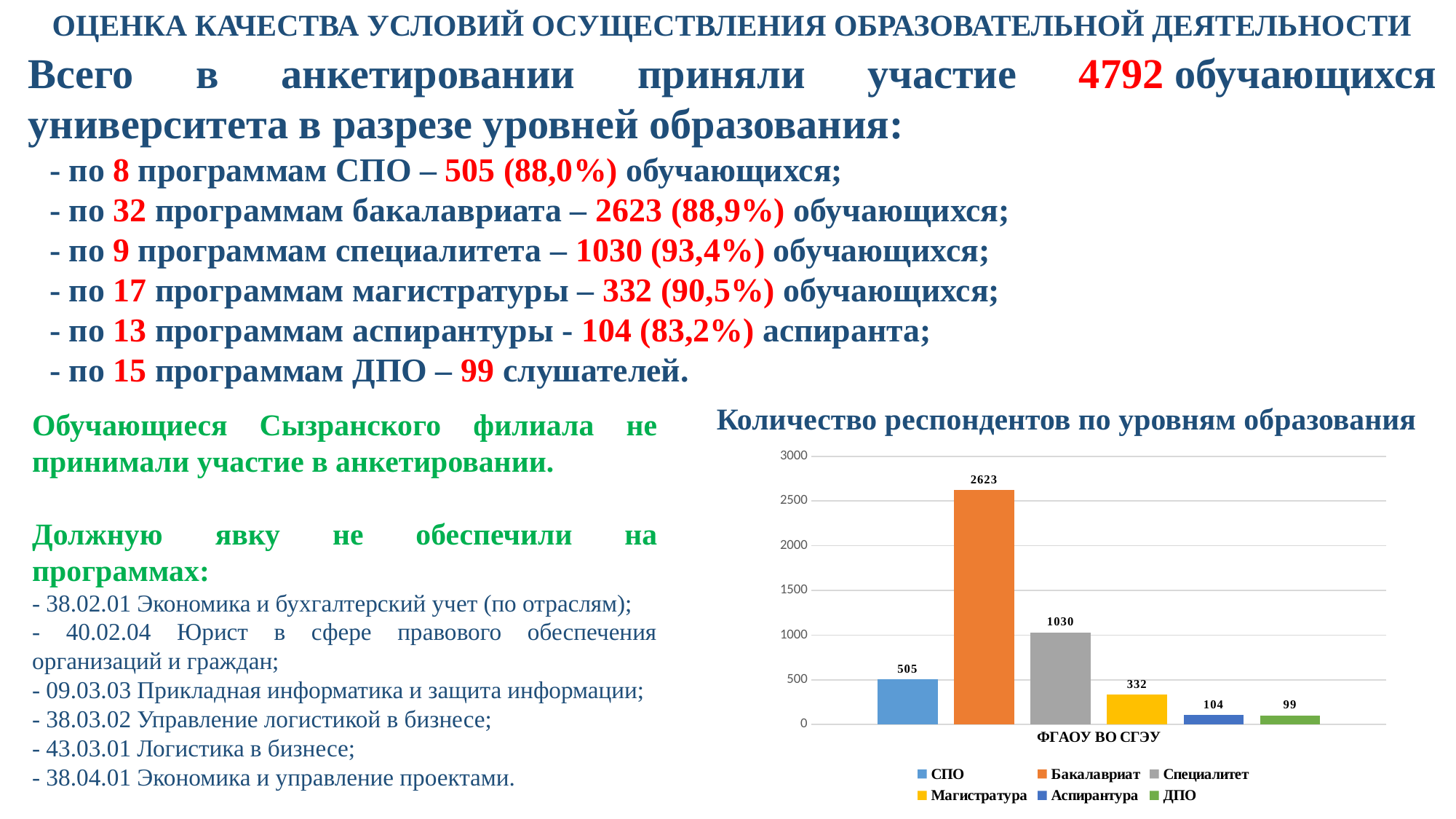
What is the difference between the values for Бакалавриат and Специалитет? 1593 Is the value for Специалитет greater or less than 1000? greater Which is larger, the value for СПО or the value for Магистратура? СПО What is the value for Аспирантура in the chart? 104 What is the value for Бакалавриат in the chart? 2623 Which series has the highest value in the chart? Бакалавриат Which series has the lowest value in the chart? ДПО What kind of chart is shown on the slide? bar chart What is the title of the chart? Количество респондентов по уровням образования What is the value for Специалитет in the chart? 1030 What is the difference between the values for СПО and Магистратура? 173 How many series does the legend list? 6